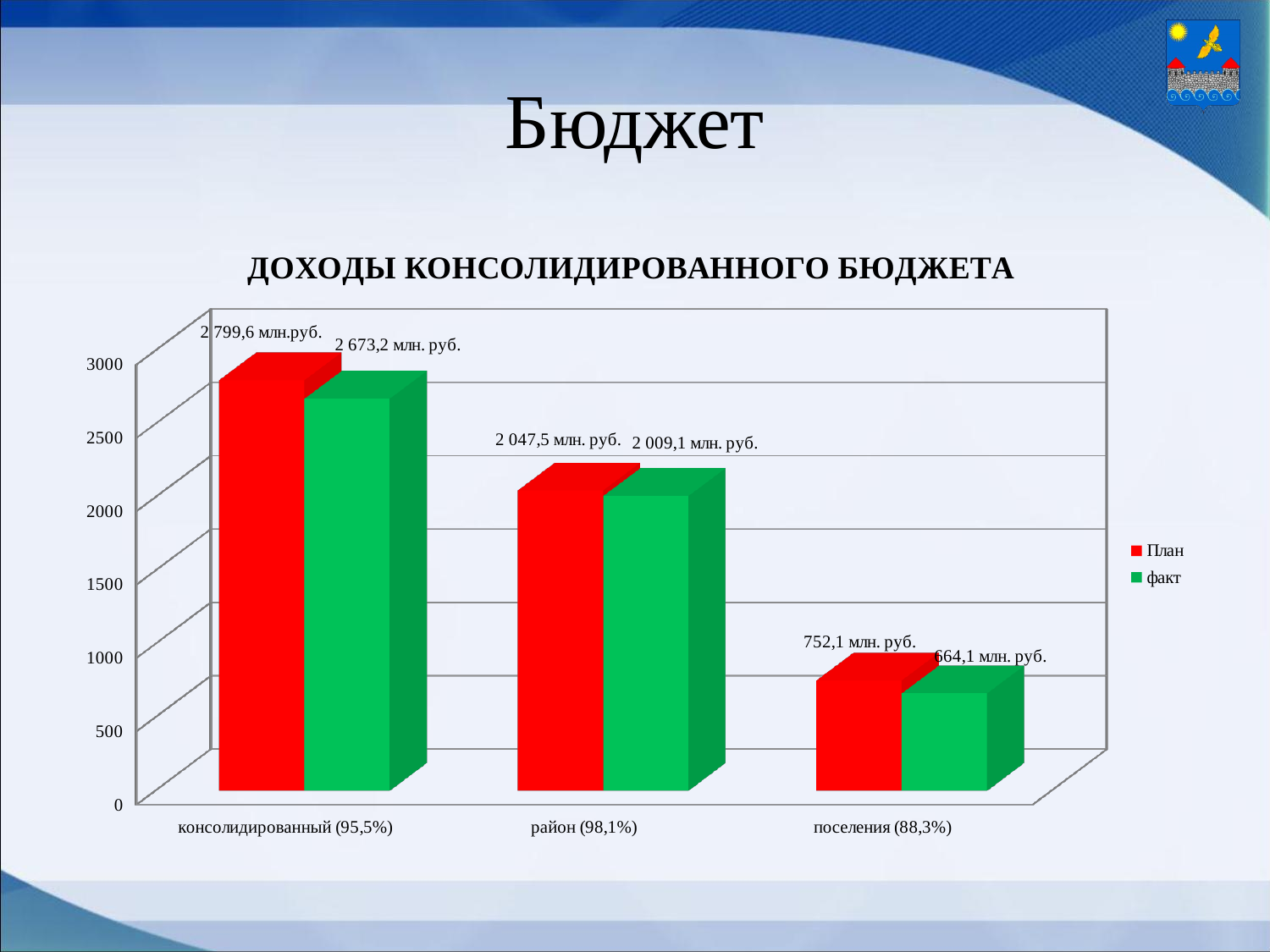
Which is larger for район (98,1%): the План value or the факт value? План What is the difference between the План and факт values for консолидированный (95,5%)? 126,4 млн. руб. What is the факт value for район (98,1%)? 2 009,1 млн. руб. What kind of chart is shown on the slide? Bar chart How many categories are shown on the x axis? 3 What is the difference between the План and факт values for поселения (88,3%)? 88,0 млн. руб. Which category has the highest План value? консолидированный (95,5%) What is the План value for поселения (88,3%)? 752,1 млн. руб. Which category has the lowest факт value? поселения (88,3%) What is the факт value for поселения (88,3%)? 664,1 млн. руб. How many series does the legend list? 2 What is the План value for консолидированный (95,5%)? 2 799,6 млн.руб.